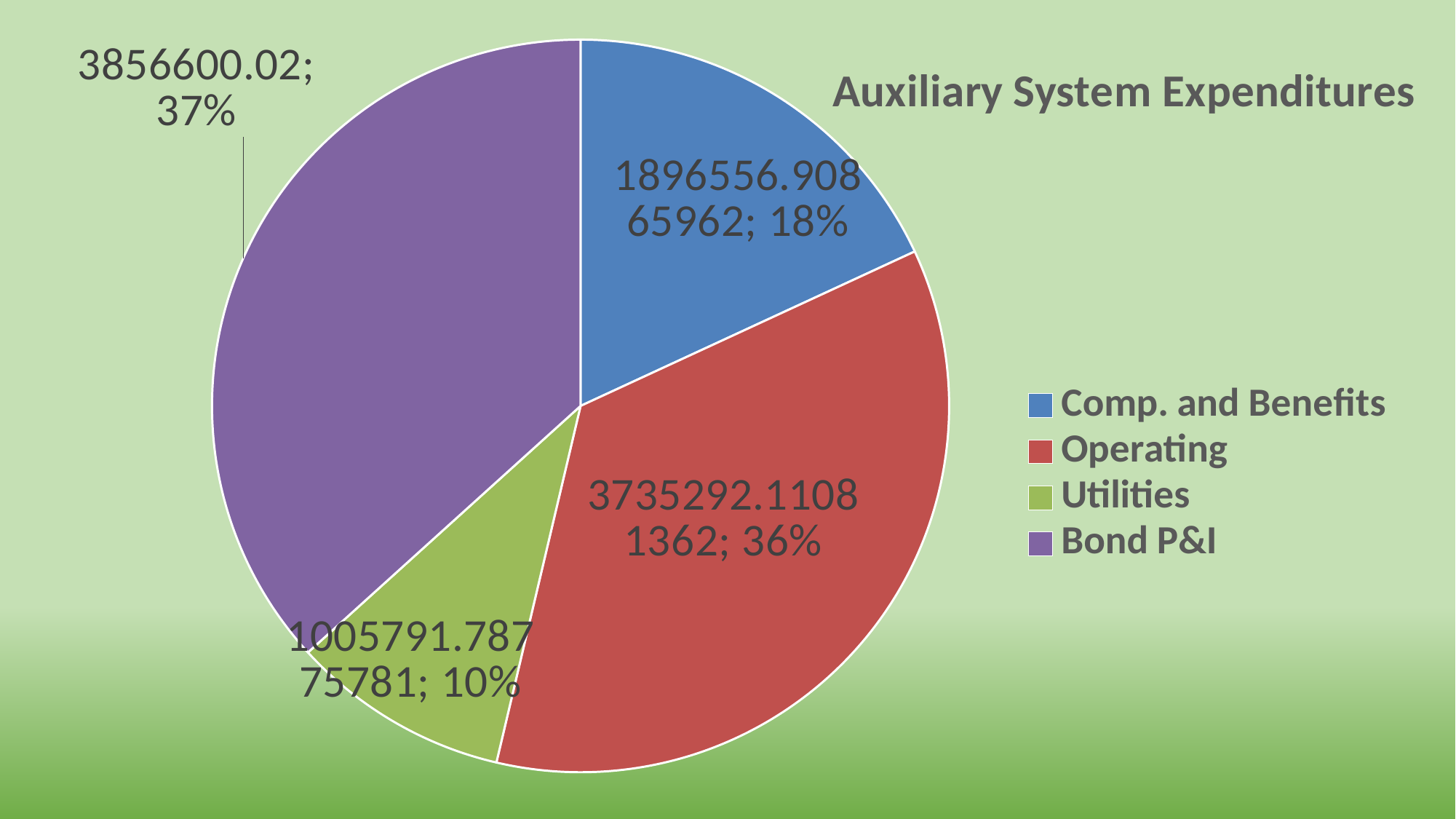
What is the title of the chart? Auxiliary System Expenditures How many slices does the pie chart have? 4 What type of chart is shown on the slide? pie chart Which is larger, the share for Comp. and Benefits or the share for Utilities? Comp. and Benefits Which category has the largest share of the pie? Bond P&I What share of the pie does Comp. and Benefits represent? 18% Which category has the smallest share of the pie? Utilities How many entries does the legend list? 4 What share of the pie does Utilities represent? 10% What is the value shown for Bond P&I? 3856600.02 What share of the pie does Operating represent? 36%